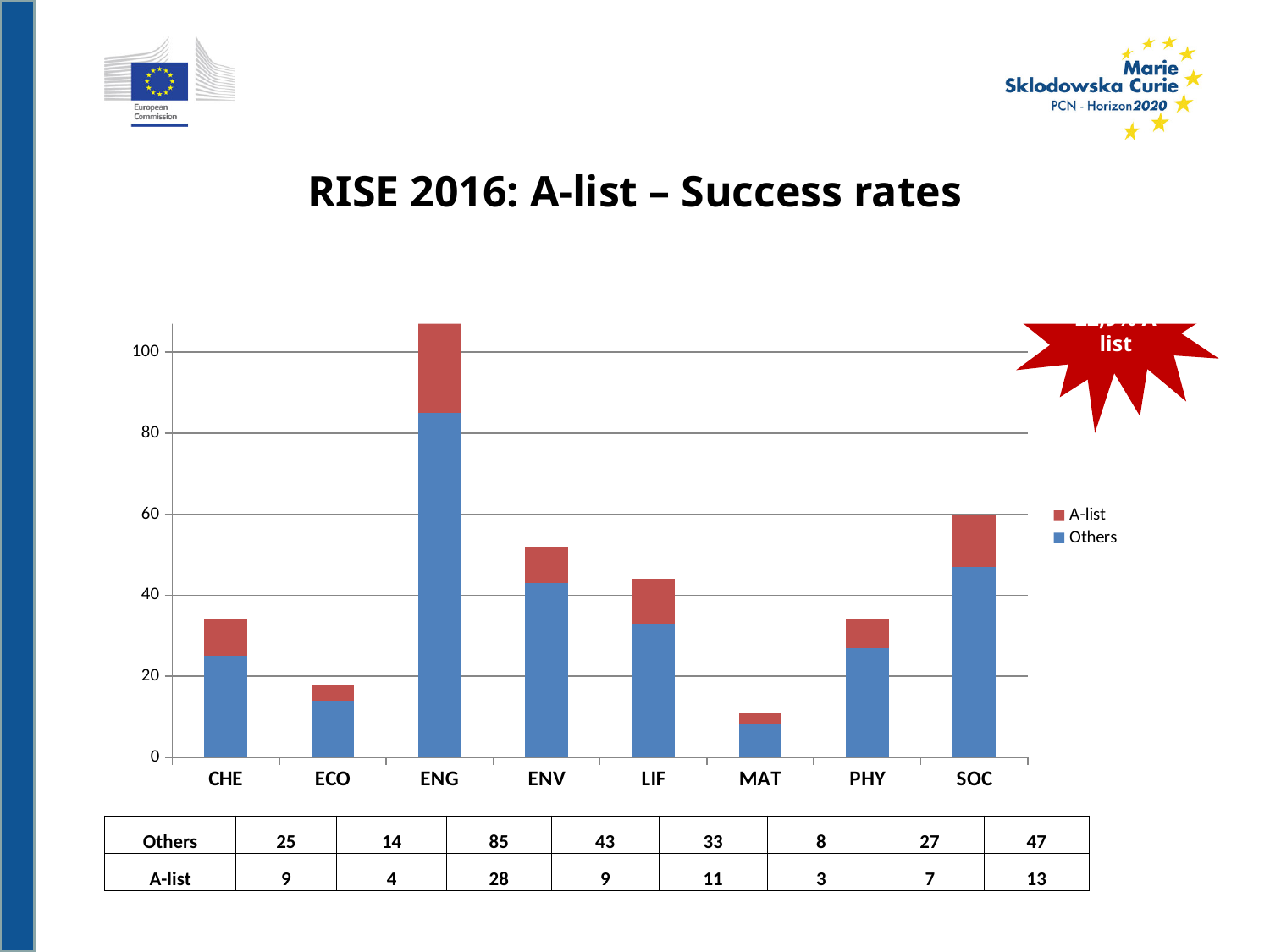
What is the difference between the Others values for ENV and LIF? 10 How many series does the legend list? 2 How many categories are shown on the x axis? 8 Is the total stacked bar for SOC greater or less than 40? greater What is the Others value for ENG? 85 What kind of chart is shown on the slide? stacked bar chart What is the total of the stacked bar for ENG? 113 Which category has the lowest A-list value? MAT Which category has the highest Others value? ENG Which colour represents the A-list series in the legend? red What is the A-list value for SOC? 13 Which is larger, the A-list value for LIF or the A-list value for PHY? LIF